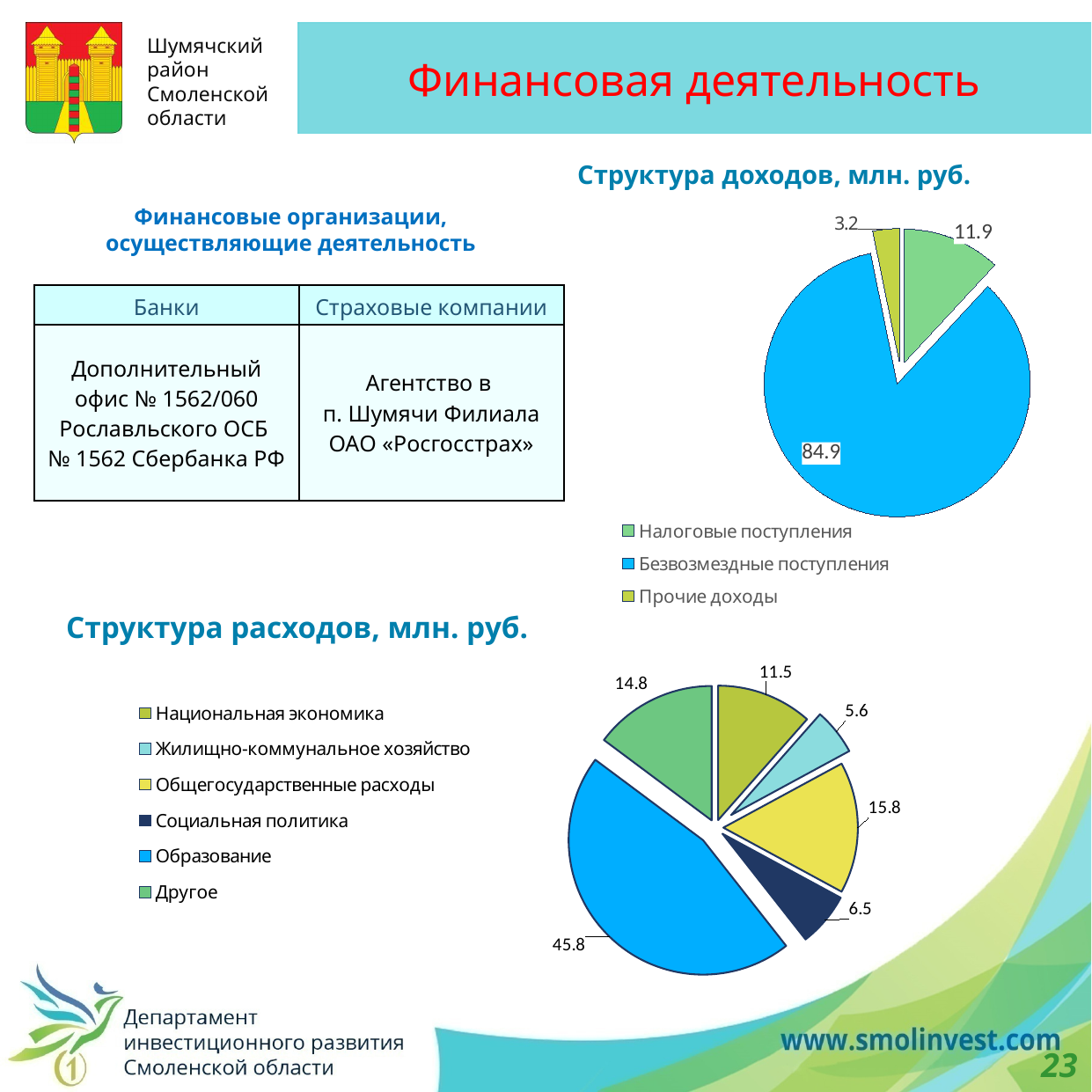
In the chart titled "Структура расходов, млн. руб.", which is larger: Общегосударственные расходы or Другое? Общегосударственные расходы In the chart titled "Структура расходов, млн. руб.", how many categories does the legend list? 6 In the chart titled "Структура расходов, млн. руб.", what is the difference between Национальная экономика and Социальная политика? 5.0 In the chart titled "Структура доходов, млн. руб.", what is the difference between Безвозмездные поступления and Налоговые поступления? 73.0 In the chart titled "Структура доходов, млн. руб.", what is the value for Налоговые поступления? 11.9 What kind of chart is the chart titled "Структура расходов, млн. руб."? Pie chart In the chart titled "Структура расходов, млн. руб.", which category has the largest value? Образование In the chart titled "Структура расходов, млн. руб.", what is the value for Жилищно-коммунальное хозяйство? 5.6 In the chart titled "Структура расходов, млн. руб.", what is the value for Образование? 45.8 In the chart titled "Структура доходов, млн. руб.", what is the value for Безвозмездные поступления? 84.9 In the chart titled "Структура доходов, млн. руб.", how many categories does the legend list? 3 In the chart titled "Структура доходов, млн. руб.", which category has the smallest value? Прочие доходы